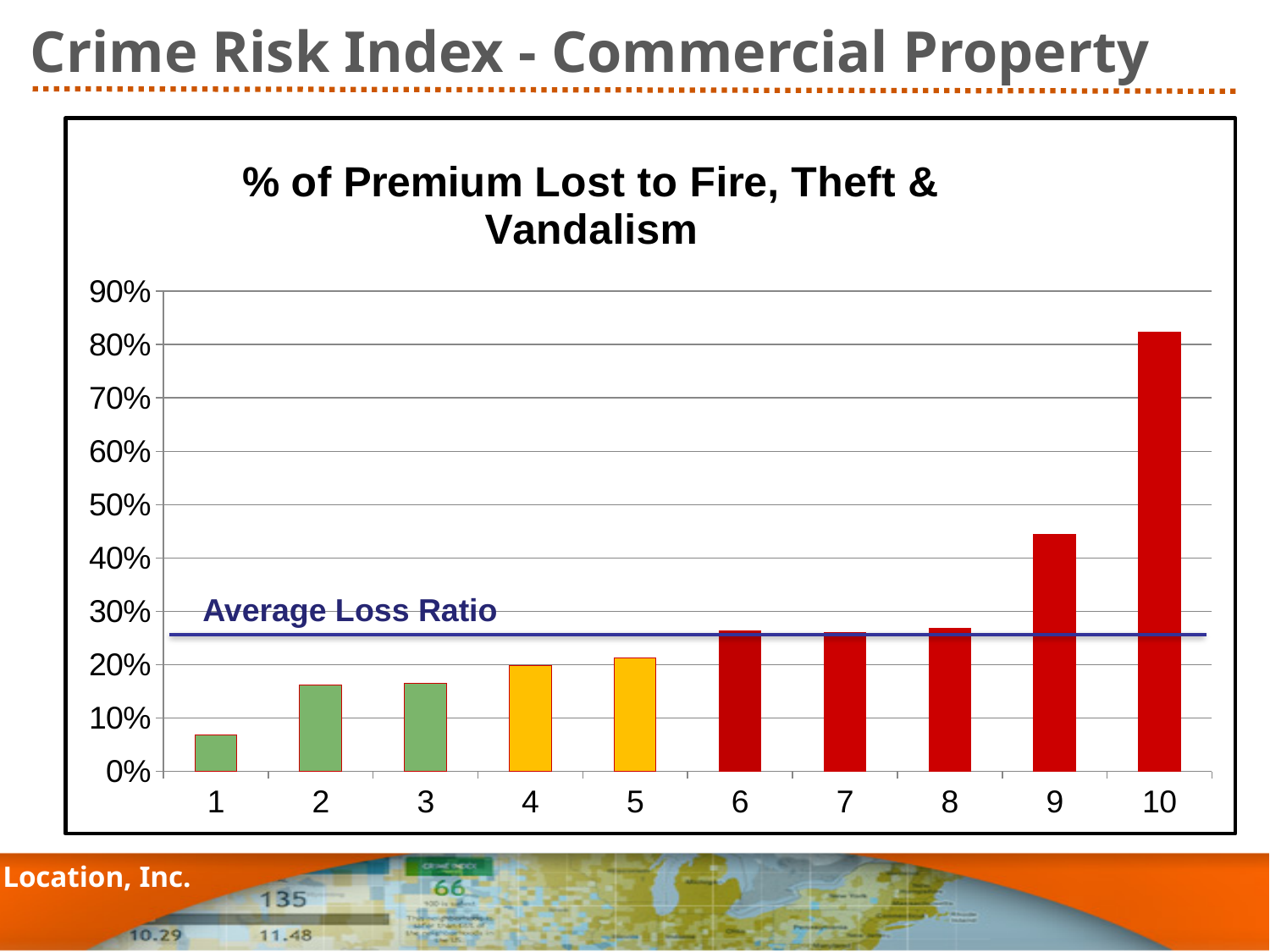
Is the value for category 9 greater or less than 40%? greater Which category has the highest value in the chart? 10 Which category has the lowest value in the chart? 1 What is the title of the chart? % of Premium Lost to Fire, Theft & Vandalism How many categories are shown on the x axis of the chart? 10 Do the values generally rise or fall as the category number increases from 1 to 10? rise Is the value for category 1 greater or less than 10%? less What is the label of the horizontal line drawn across the chart? Average Loss Ratio Is the value for category 4 greater or less than 30%? less What kind of chart is shown on the slide? Bar chart Which has a larger value, category 9 or category 10? 10